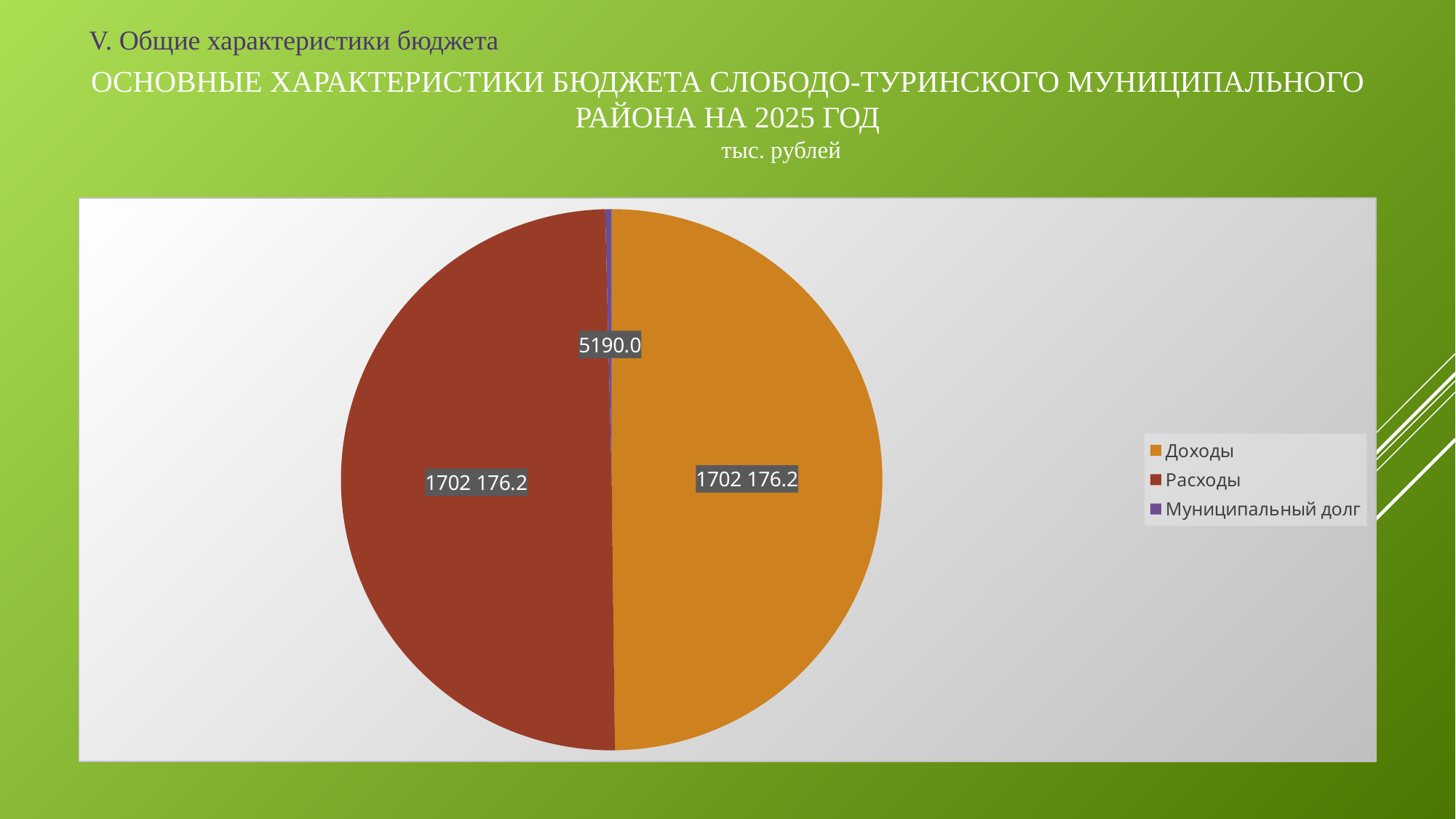
What is the value for Расходы? 1702 176.2 Which category has the smallest slice of the pie? Муниципальный долг What is the difference between the values for Расходы and Муниципальный долг? 1696 986.2 What is the value for Доходы? 1702 176.2 How many entries does the legend list? 3 Which colour represents Расходы in the legend? Red-brown Which is larger, Доходы or Расходы? They are equal What unit is stated under the chart title? тыс. рублей What is the value for Муниципальный долг? 5190.0 How many slices does the pie chart have? 3 What kind of chart is shown on the slide? pie chart Which is larger, Доходы or Муниципальный долг? Доходы